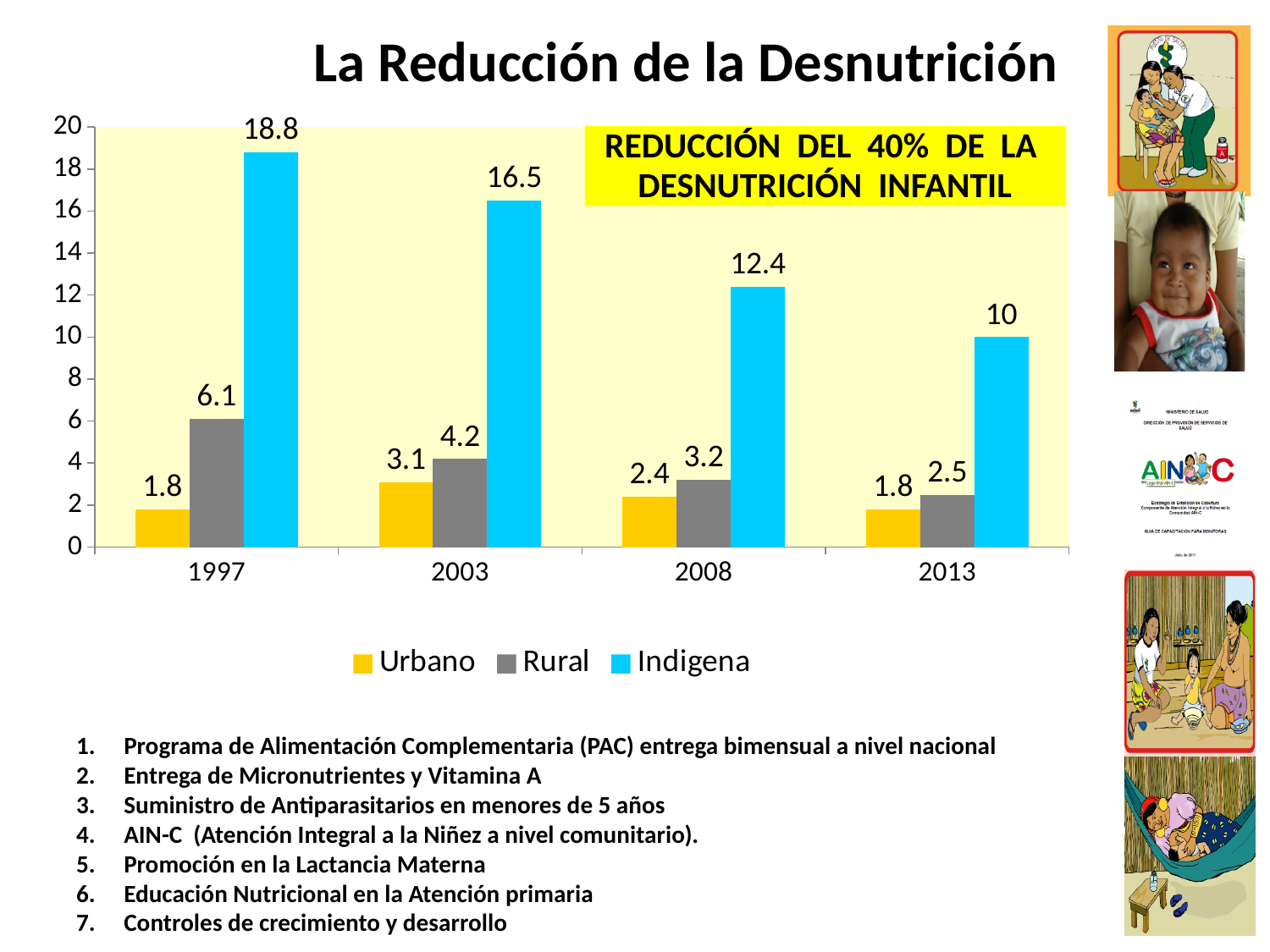
What is the difference between the Indigena values for 1997 and 2013? 8.8 Which series is shown in light blue in the legend? Indigena What is the value for Urbano in 2008? 2.4 What is the value for Rural in 2003? 4.2 Which is larger, the Rural value in 1997 or the Rural value in 2008? Rural in 1997 What kind of chart is shown on the slide? Bar chart In which year is the Indigena value highest? 1997 What is the value for Indigena in 1997? 18.8 Does the Indigena value rise or fall from 1997 to 2013? Fall In which year is the Rural value lowest? 2013 How many series does the legend list? 3 How many years are shown on the x axis? 4